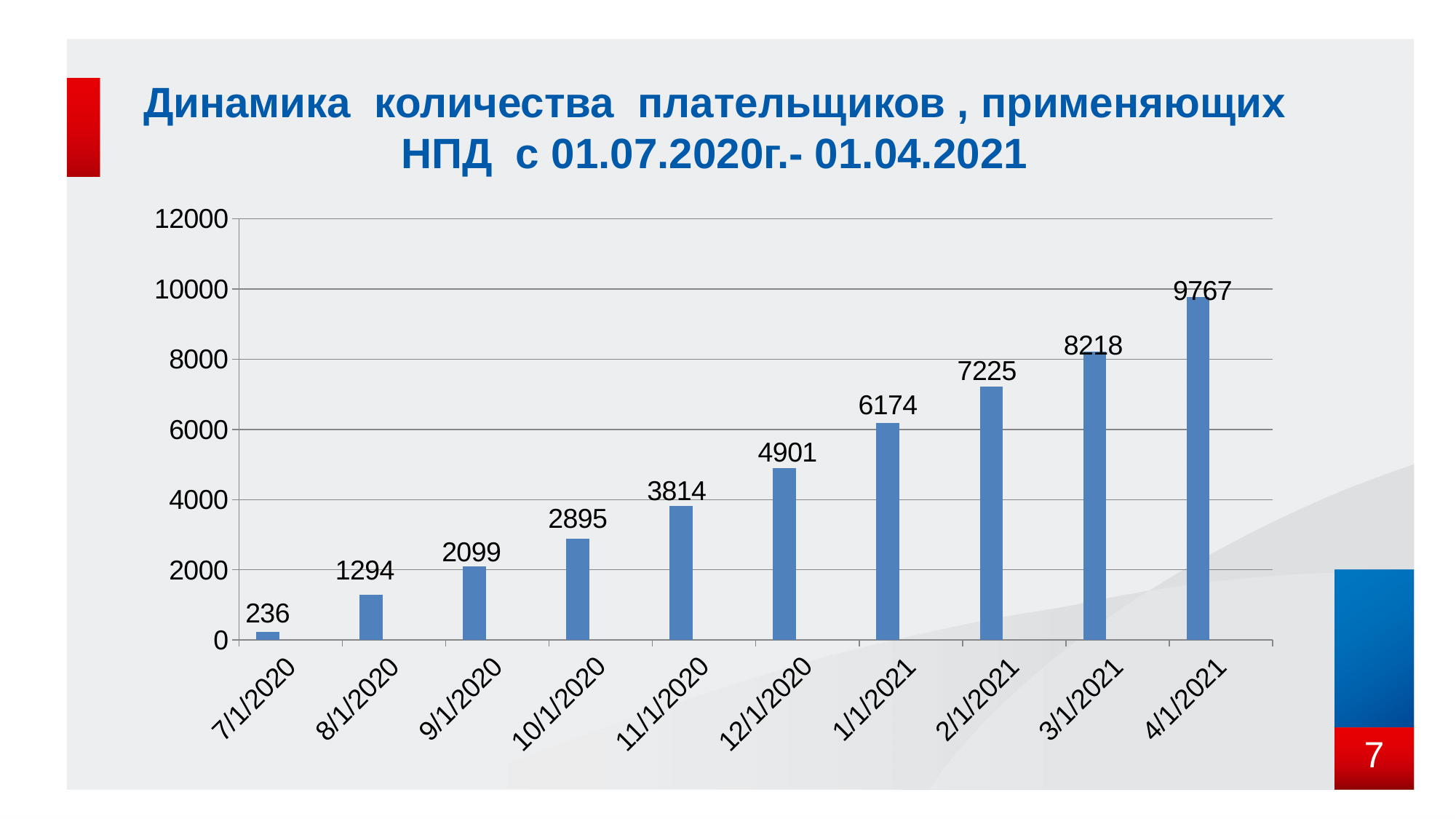
What is the value for 7/1/2020? 236 Do the values rise or fall from 7/1/2020 to 4/1/2021? rise Is the value for 11/1/2020 greater or less than 4000? less Which is larger, the value for 9/1/2020 or the value for 10/1/2020? 10/1/2020 What is the value for 2/1/2021? 7225 How many dates are shown on the x axis? 10 Which date has the highest value? 4/1/2021 What kind of chart is shown on the slide? bar chart What is the difference between the values for 1/1/2021 and 12/1/2020? 1273 Which date has the lowest value? 7/1/2020 What is the difference between the values for 4/1/2021 and 3/1/2021? 1549 What is the value for 12/1/2020? 4901